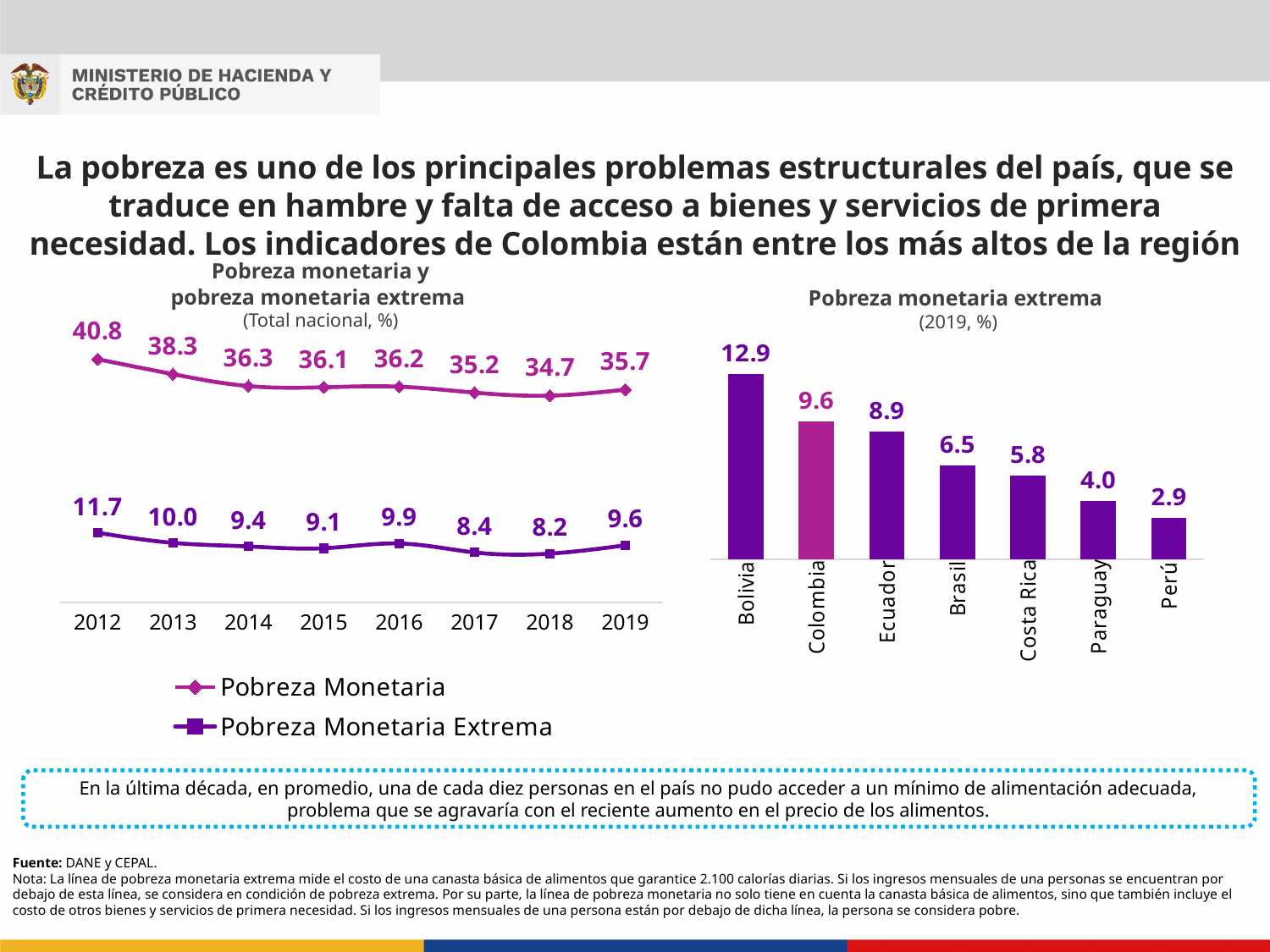
In the right chart 'Pobreza monetaria extrema (2019, %)', which country has the highest value? Bolivia In the right chart 'Pobreza monetaria extrema (2019, %)', what is the difference between Bolivia and Perú? 10.0 In the right chart 'Pobreza monetaria extrema (2019, %)', what is the value for Colombia? 9.6 In the left chart 'Pobreza monetaria y pobreza monetaria extrema', does Pobreza Monetaria generally rise or fall from 2012 to 2018? fall In the left chart 'Pobreza monetaria y pobreza monetaria extrema', which year has the lowest Pobreza Monetaria Extrema value? 2018 In the left chart 'Pobreza monetaria y pobreza monetaria extrema', how many series does the legend list? 2 What kind of chart is the right chart 'Pobreza monetaria extrema (2019, %)'? bar chart In the left chart 'Pobreza monetaria y pobreza monetaria extrema', which year has the highest Pobreza Monetaria value? 2012 In the left chart 'Pobreza monetaria y pobreza monetaria extrema', what is the value of Pobreza Monetaria in 2012? 40.8 In the left chart 'Pobreza monetaria y pobreza monetaria extrema', what is the difference between Pobreza Monetaria and Pobreza Monetaria Extrema in 2019? 26.1 In the left chart 'Pobreza monetaria y pobreza monetaria extrema', what is the value of Pobreza Monetaria Extrema in 2018? 8.2 In the right chart 'Pobreza monetaria extrema (2019, %)', how many countries are shown? 7